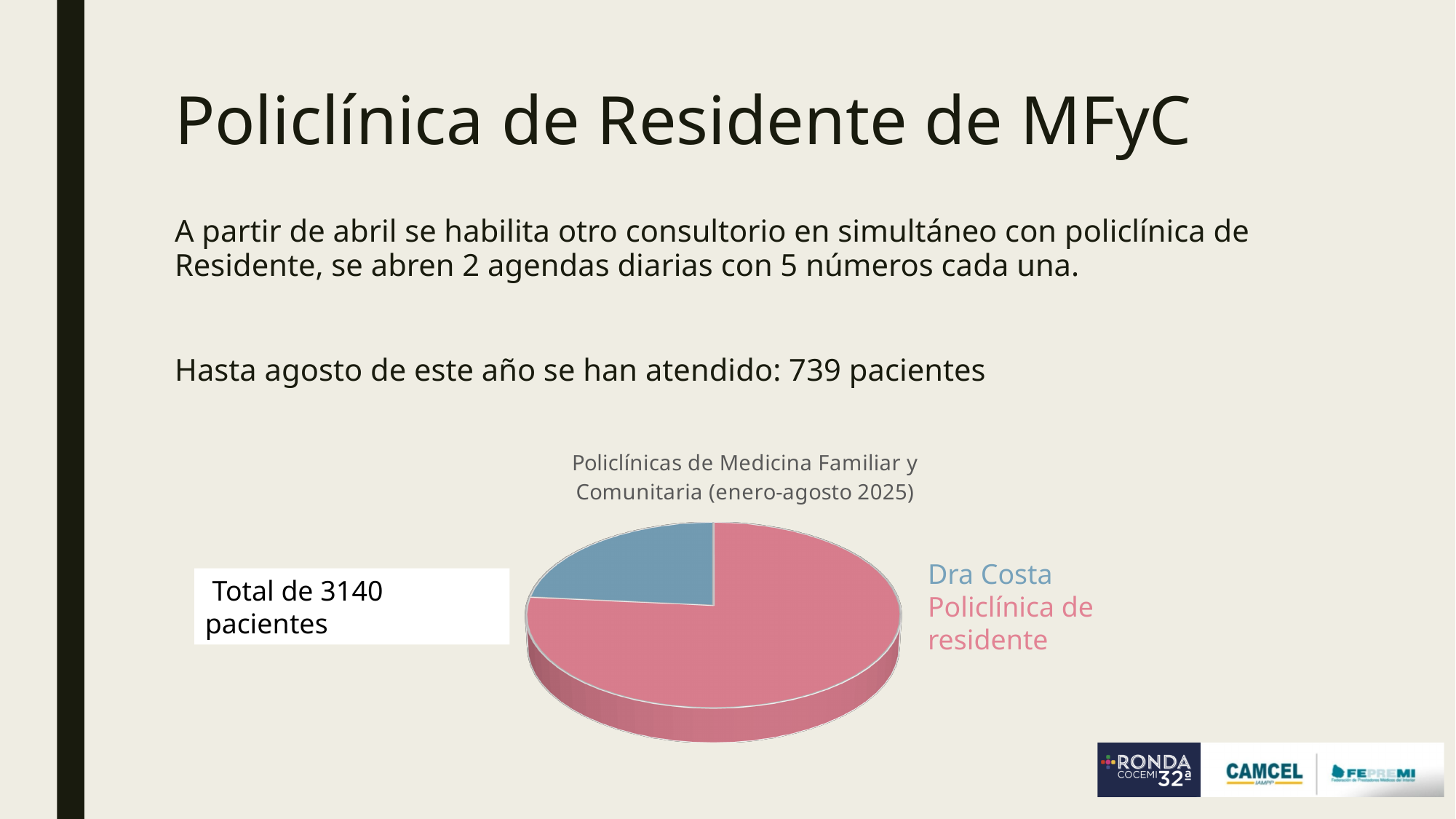
What is the title of the pie chart? Policlínicas de Medicina Familiar y Comunitaria (enero-agosto 2025) Which slice of the pie chart is the largest? Policlínica de residente Is the Policlínica de residente slice more or less than half of the pie? more What colour is the Dra Costa slice in the pie chart? blue What kind of chart is shown on the slide? pie chart Which slice is larger, Dra Costa or Policlínica de residente? Policlínica de residente How many slices does the pie chart have? 2 Is the Dra Costa slice more or less than half of the pie? less Which slice of the pie chart is the smallest? Dra Costa